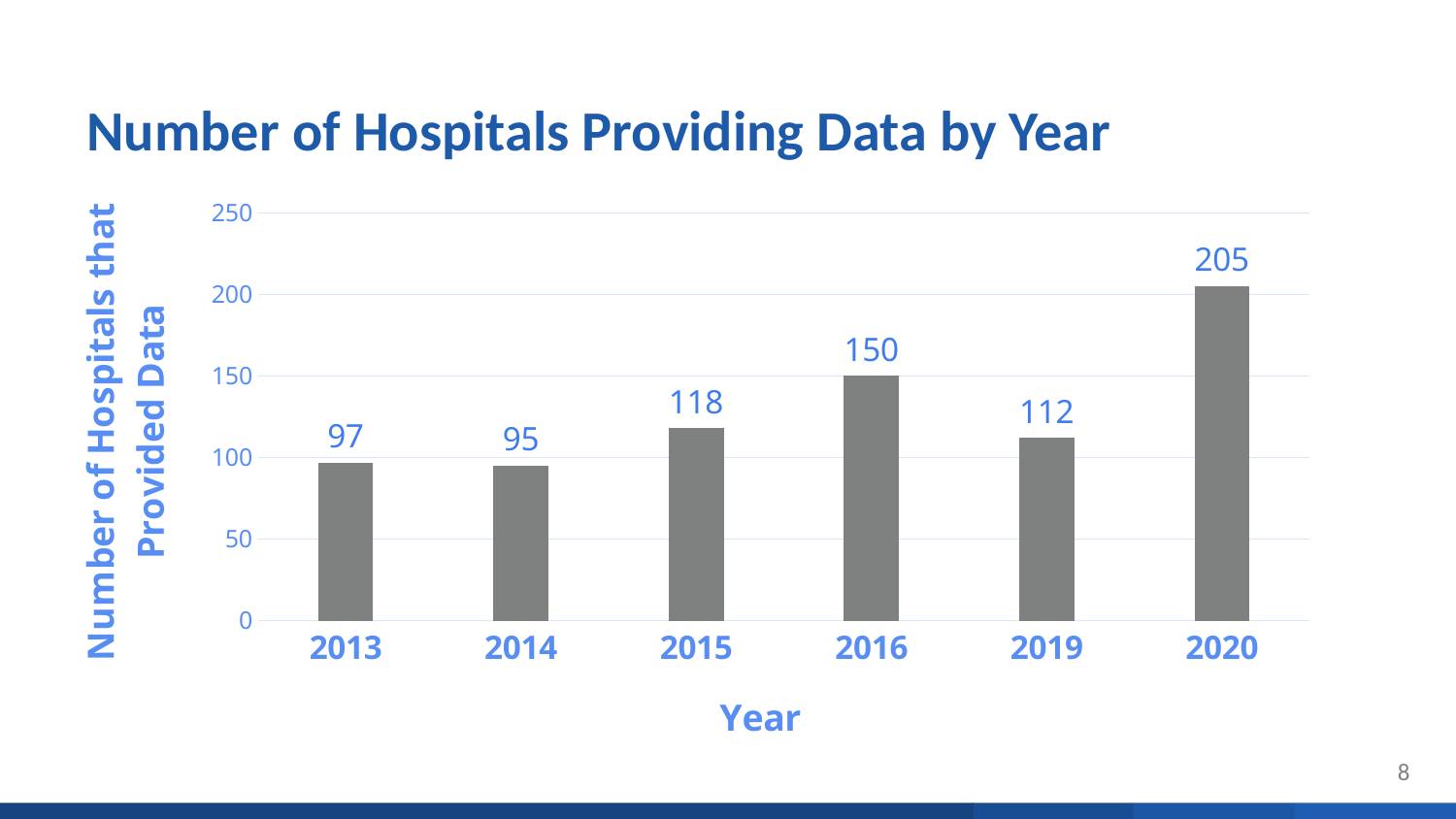
Which year has the larger value, 2015 or 2019? 2015 How many years are shown on the x axis? 6 Is the value for 2020 greater or less than 200? greater Which year has the lowest number of hospitals providing data? 2014 What is the value shown for 2019? 112 How many more hospitals provided data in 2015 than in 2013? 21 What is the label of the x axis? Year What kind of chart is shown on the slide? Bar chart How many hospitals provided data in 2016? 150 What is the difference between the values for 2020 and 2016? 55 Does the number of hospitals rise or fall from 2016 to 2019? Fall Which year has the highest number of hospitals providing data? 2020